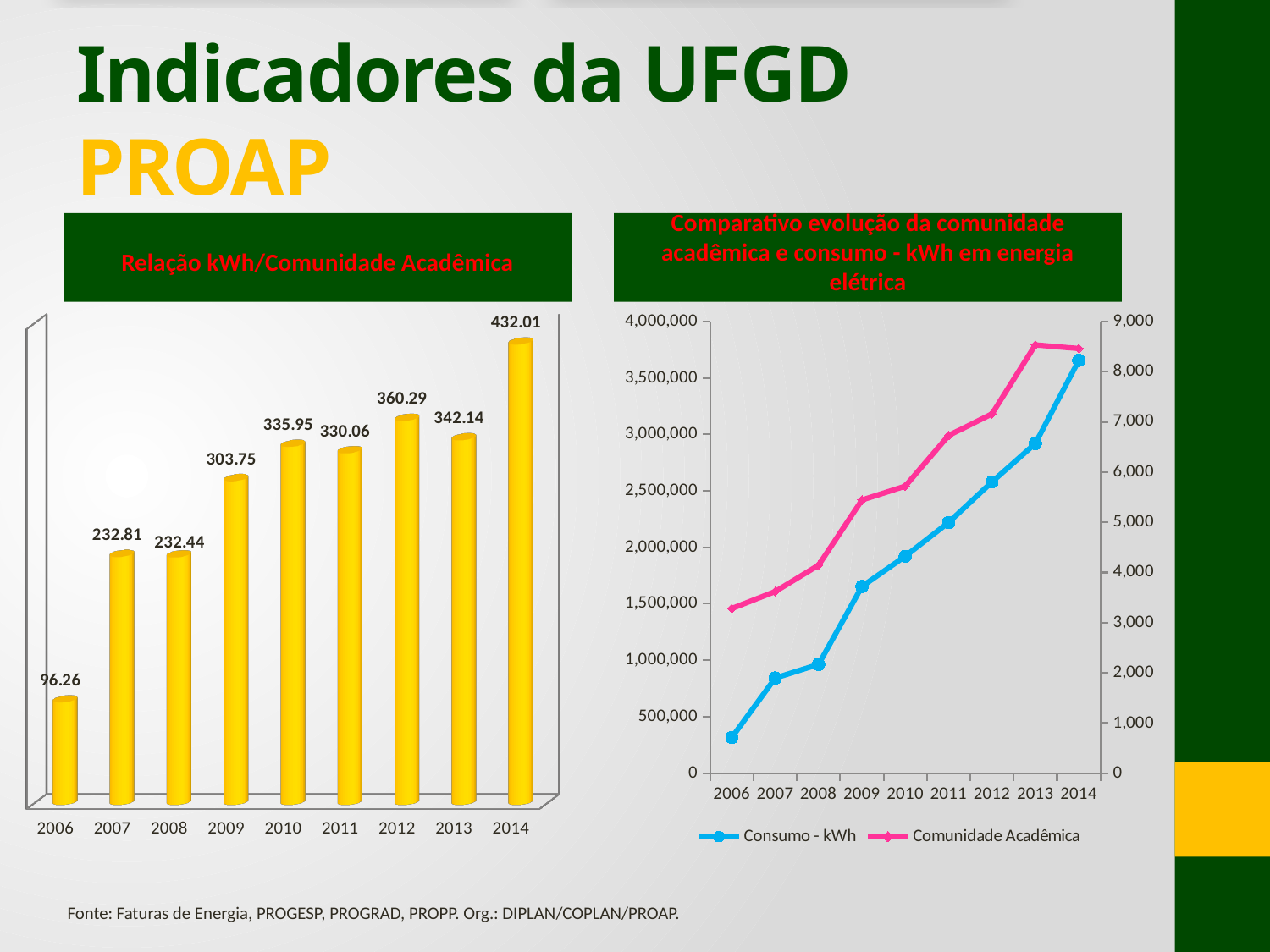
In the chart titled "Relação kWh/Comunidade Acadêmica", what is the value for 2014? 432.01 In the chart titled "Relação kWh/Comunidade Acadêmica", which year has the lowest value? 2006 In the chart titled "Relação kWh/Comunidade Acadêmica", what is the difference between the values for 2014 and 2013? 89.87 In the chart titled "Relação kWh/Comunidade Acadêmica", what is the value for 2009? 303.75 In the chart on the right, does the Consumo - kWh series generally rise or fall from 2006 to 2014? Rise In the chart on the right ("Comparativo evolução da comunidade acadêmica e consumo - kWh em energia elétrica"), how many series does the legend list? 2 In the chart on the right, is the value of Consumo - kWh for 2006 greater or less than 500,000? less In the chart titled "Relação kWh/Comunidade Acadêmica", which year has the larger value, 2012 or 2013? 2012 In the chart titled "Relação kWh/Comunidade Acadêmica", which year has the highest value? 2014 In the chart on the right, which series is drawn in pink? Comunidade Acadêmica What kind of chart is the one titled "Relação kWh/Comunidade Acadêmica"? Bar chart In the chart titled "Relação kWh/Comunidade Acadêmica", how many years are shown on the x axis? 9